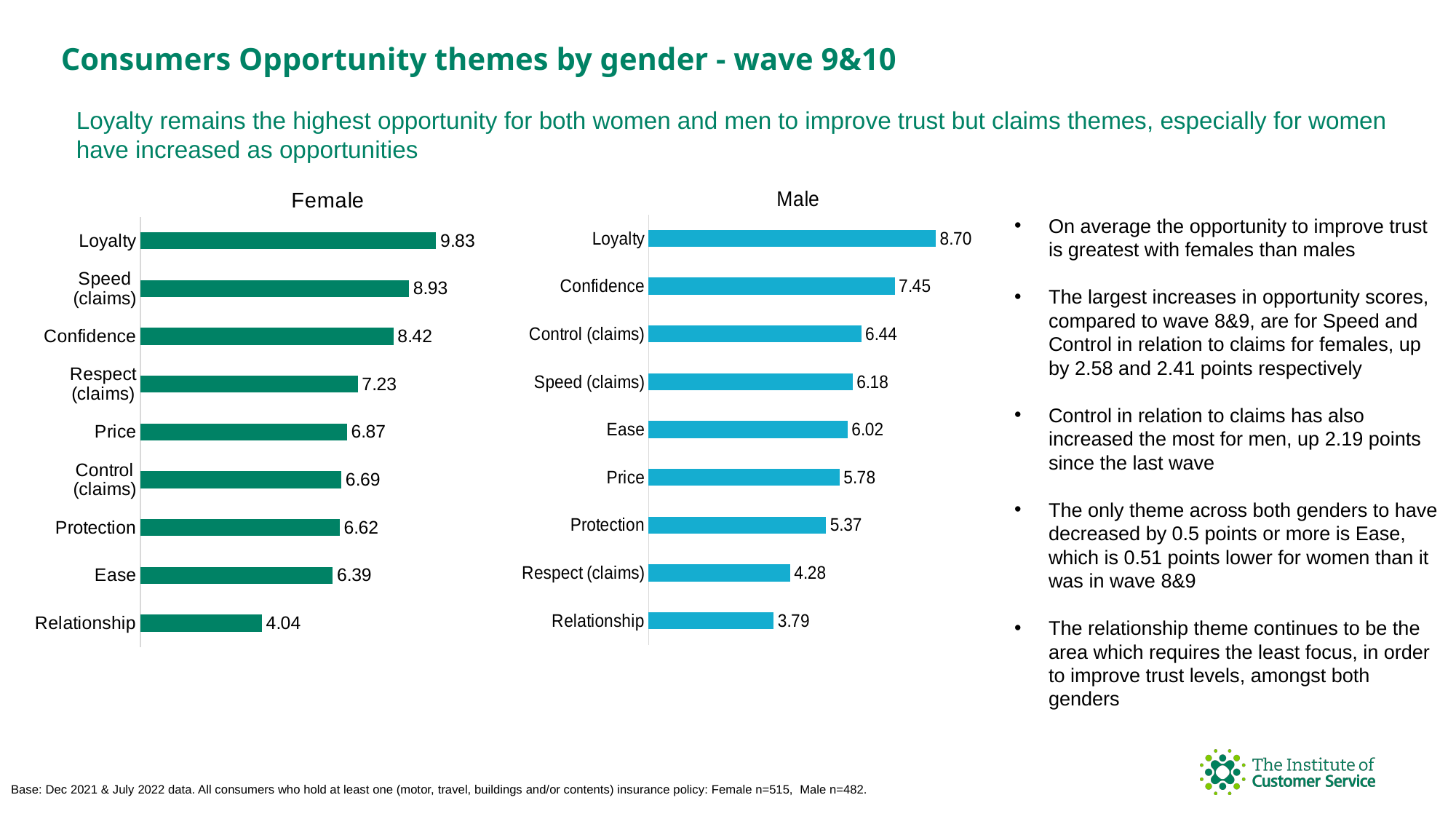
In the Male chart, which category has the lowest value? Relationship What kind of chart is the Female chart? Bar chart In the Female chart, what is the value for Loyalty? 9.83 How many categories are shown in the Male chart? 9 In the Female chart, what is the difference between Speed (claims) and Confidence? 0.51 What is the title of the chart on the left? Female In the Female chart, what is the value for Control (claims)? 6.69 In the Male chart, what is the value for Confidence? 7.45 In the Male chart, what is the value for Respect (claims)? 4.28 In the Female chart, which category has the highest value? Loyalty Which is larger: Price in the Female chart or Price in the Male chart? Price in the Female chart In the Male chart, what is the difference between Loyalty and Relationship? 4.91